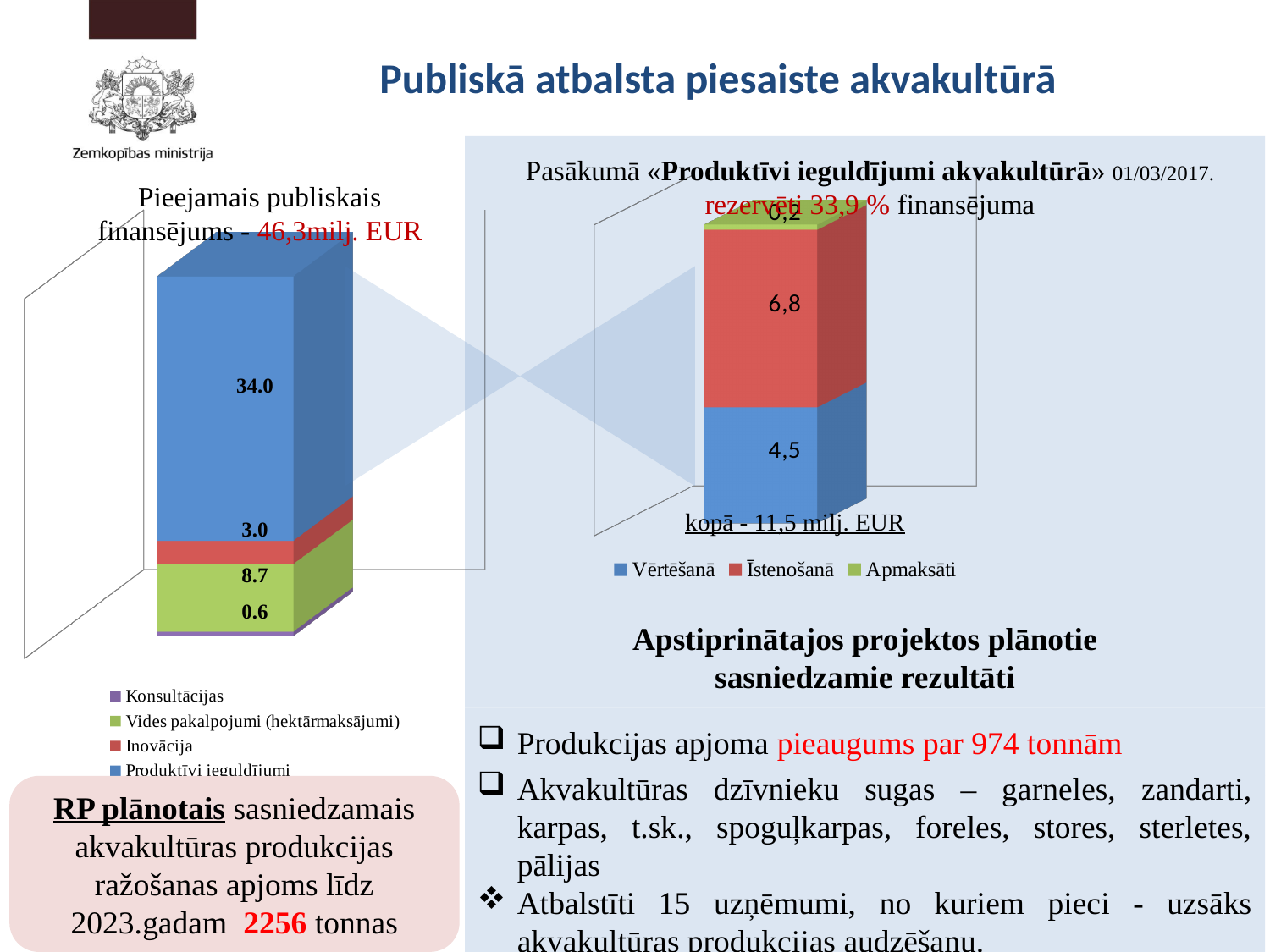
In the right chart (Produktīvi ieguldījumi akvakultūrā), what is the value for Vērtēšanā? 4,5 In the right chart (Produktīvi ieguldījumi akvakultūrā), what is the value for Īstenošanā? 6,8 In the left chart (Pieejamais publiskais finansējums), what is the value for Vides pakalpojumi (hektārmaksājumi)? 8.7 What type of chart is the right chart (Produktīvi ieguldījumi akvakultūrā)? Stacked bar chart In the left chart (Pieejamais publiskais finansējums), which segment has the largest value? Produktīvi ieguldījumi In the right chart (Produktīvi ieguldījumi akvakultūrā), what is the total of the stacked bar as stated on the slide? 11,5 milj. EUR In the right chart (Produktīvi ieguldījumi akvakultūrā), which is larger, Vērtēšanā or Īstenošanā? Īstenošanā In the left chart (Pieejamais publiskais finansējums), what is the difference between Produktīvi ieguldījumi and Inovācija? 31.0 In the left chart (Pieejamais publiskais finansējums), which segment has the smallest value? Konsultācijas In the left chart (Pieejamais publiskais finansējums), what is the value for Konsultācijas? 0.6 In the left chart (Pieejamais publiskais finansējums), what is the value for Produktīvi ieguldījumi? 34.0 In the left chart (Pieejamais publiskais finansējums), how many segments does the legend list? 4